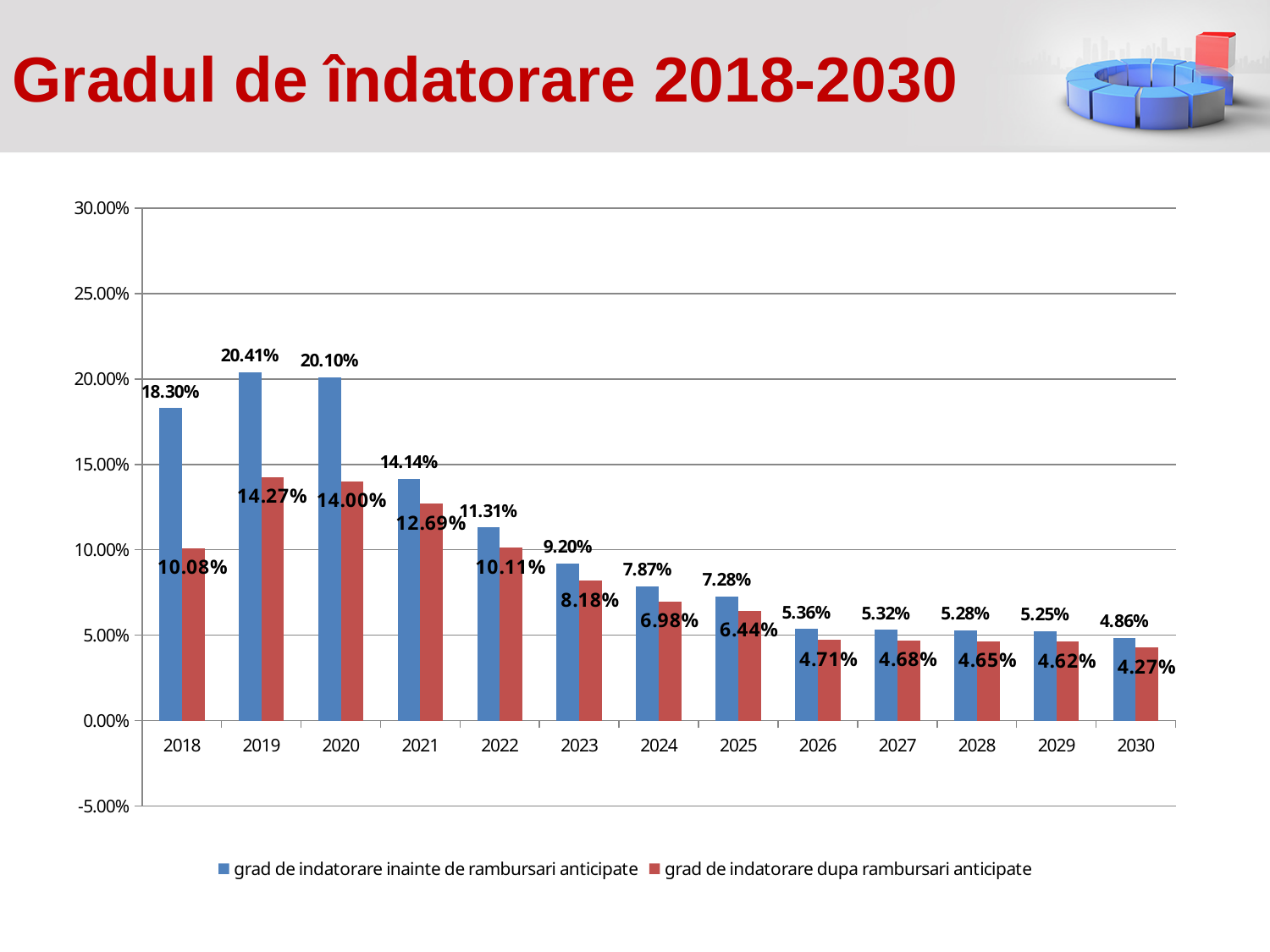
What is the difference between 'grad de indatorare inainte de rambursari anticipate' and 'grad de indatorare dupa rambursari anticipate' in 2018? 8.22% How many years are shown on the x axis? 13 How many series does the legend list? 2 Which is larger in 2020: 'grad de indatorare inainte de rambursari anticipate' or 'grad de indatorare dupa rambursari anticipate'? grad de indatorare inainte de rambursari anticipate In which year is 'grad de indatorare inainte de rambursari anticipate' highest? 2019 In which year is 'grad de indatorare dupa rambursari anticipate' lowest? 2030 What kind of chart is shown on the slide? bar chart Do the values of 'grad de indatorare inainte de rambursari anticipate' rise or fall from 2019 to 2030? fall What is the value of 'grad de indatorare dupa rambursari anticipate' for 2030? 4.27% What is the value of 'grad de indatorare dupa rambursari anticipate' for 2021? 12.69% Is the value of 'grad de indatorare inainte de rambursari anticipate' for 2022 greater or less than 10.00%? greater What is the value of 'grad de indatorare inainte de rambursari anticipate' for 2018? 18.30%